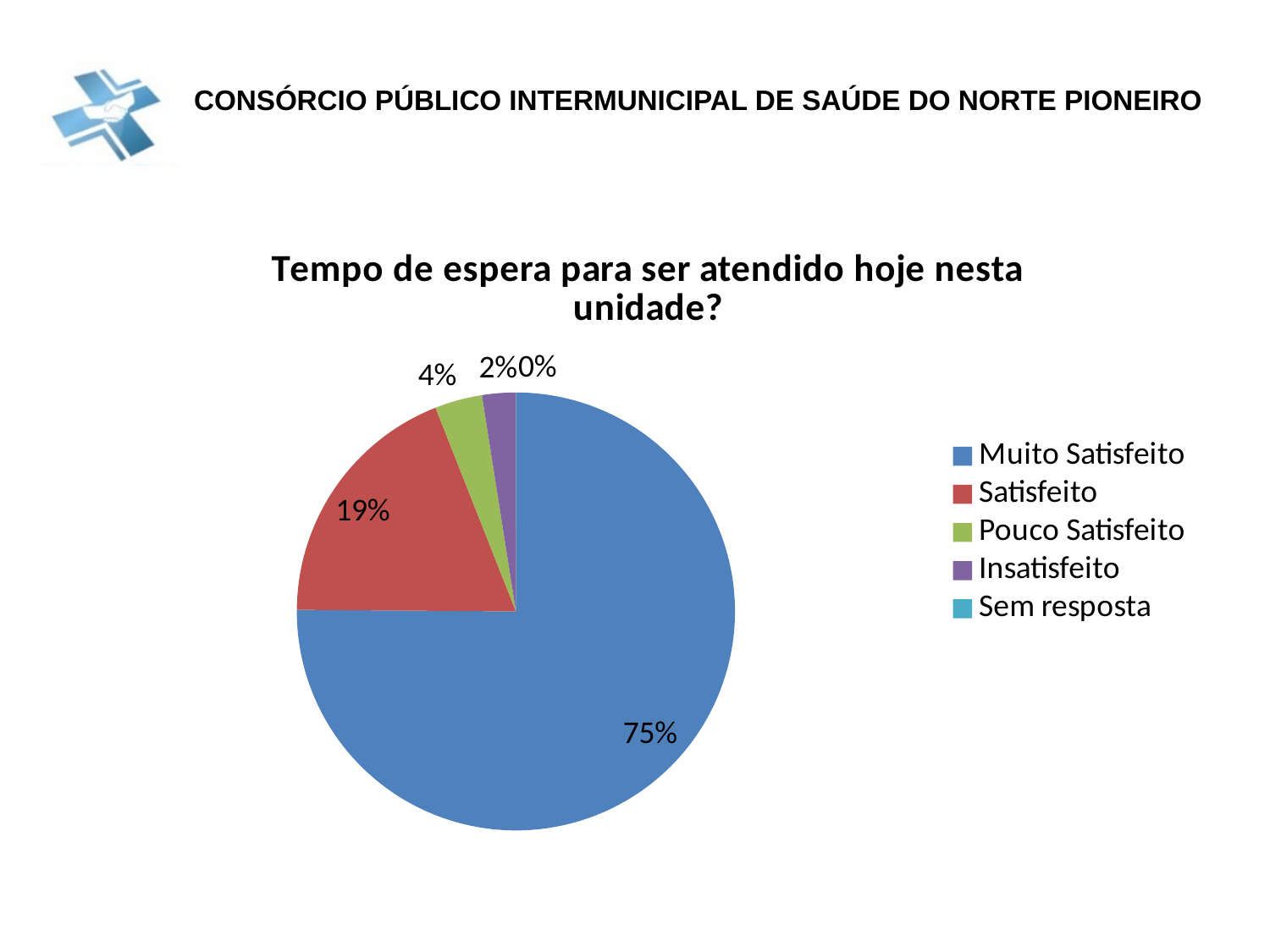
What is the difference between the Muito Satisfeito and Satisfeito shares? 56% How many categories does the legend list? 5 Which is larger, the share for Pouco Satisfeito or the share for Insatisfeito? Pouco Satisfeito What share of the pie does Muito Satisfeito represent? 75% What is the value shown for Satisfeito? 19% Which category has the smallest slice of the pie? Sem resposta What is the value shown for Pouco Satisfeito? 4% What is the value shown for Sem resposta? 0% Which category has the largest slice of the pie? Muito Satisfeito What is the title of the chart? Tempo de espera para ser atendido hoje nesta unidade? What is the value shown for Insatisfeito? 2% What kind of chart is shown on the slide? Pie chart